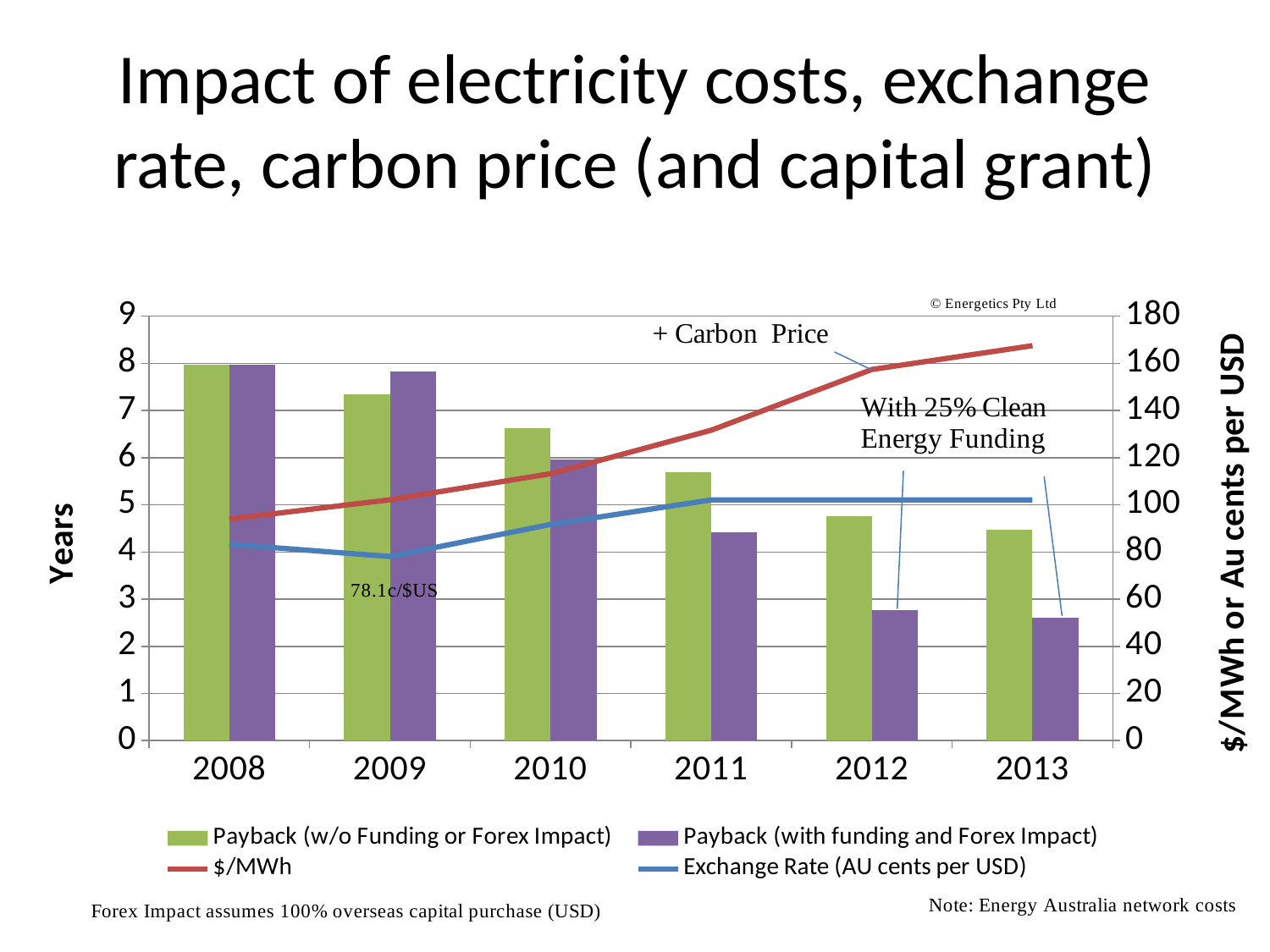
How many years are shown on the x axis of the chart? 6 In which year is the Payback (w/o Funding or Forex Impact) bar highest? 2008 What kind of chart is shown on the slide? A combination bar and line chart In 2011, which is larger: Payback (w/o Funding or Forex Impact) or Payback (with funding and Forex Impact)? Payback (w/o Funding or Forex Impact) Is the Payback (with funding and Forex Impact) value for 2011 greater or less than 4 years? greater Is the Payback (w/o Funding or Forex Impact) value for 2010 greater or less than 6 years? greater Is the $/MWh value for 2013 greater or less than 160? greater How many series does the chart legend list? 4 What exchange rate value is annotated on the chart for 2009? 78.1c/$US Does the $/MWh line rise or fall from 2008 to 2013? It rises